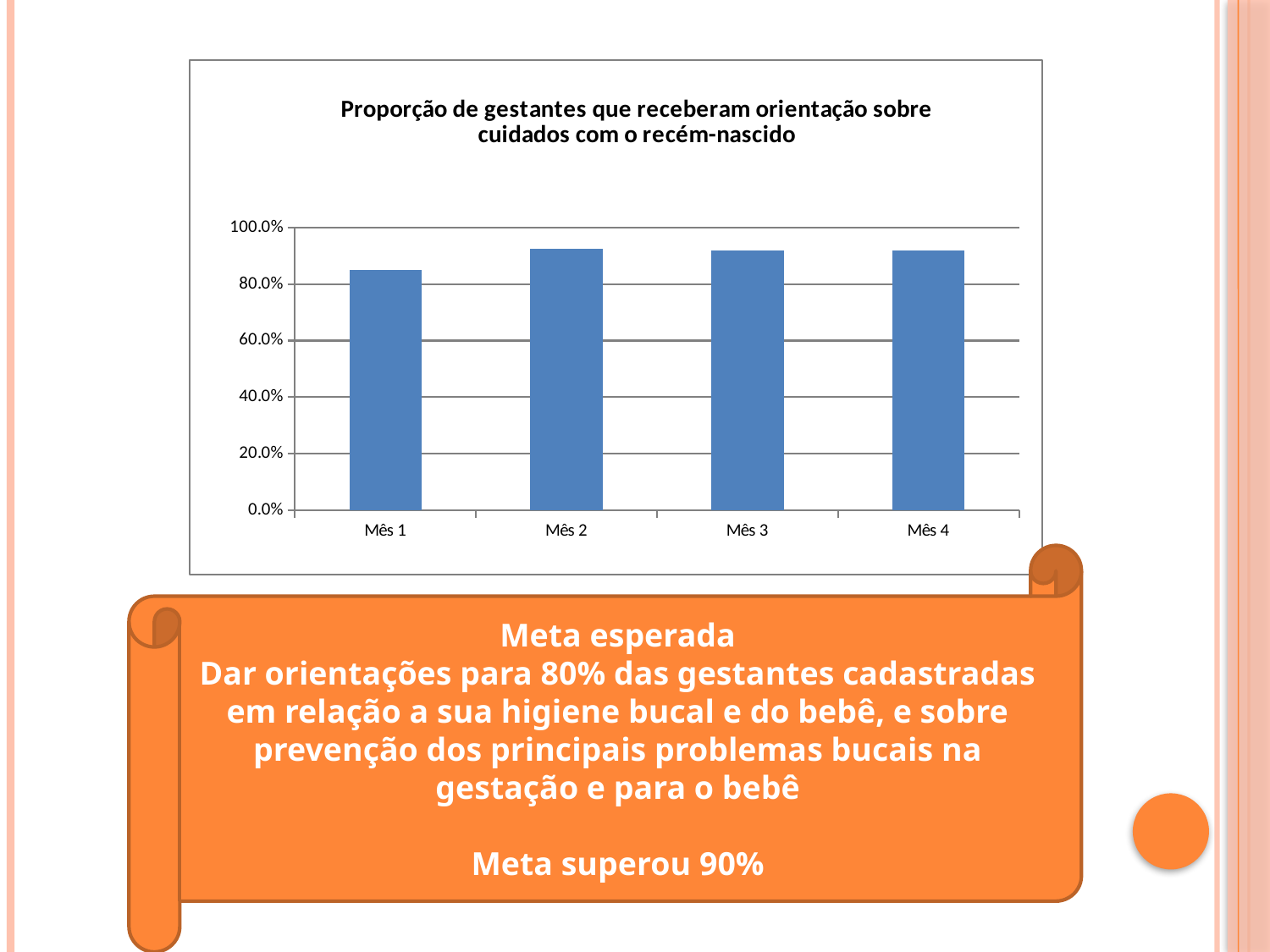
What is the title of the chart? Proporção de gestantes que receberam orientação sobre cuidados com o recém-nascido What is the highest tick value shown on the y axis? 100.0% Which month has the lowest value? Mês 1 Which is larger, the value for Mês 1 or the value for Mês 2? Mês 2 Which is larger, the value for Mês 1 or the value for Mês 4? Mês 4 Is the value for Mês 4 greater or less than 100.0%? less What kind of chart is shown on the slide? bar chart Is the value for Mês 3 greater or less than 60.0%? greater Is the value for Mês 2 greater or less than 80.0%? greater How many categories (months) are plotted on the x axis? 4